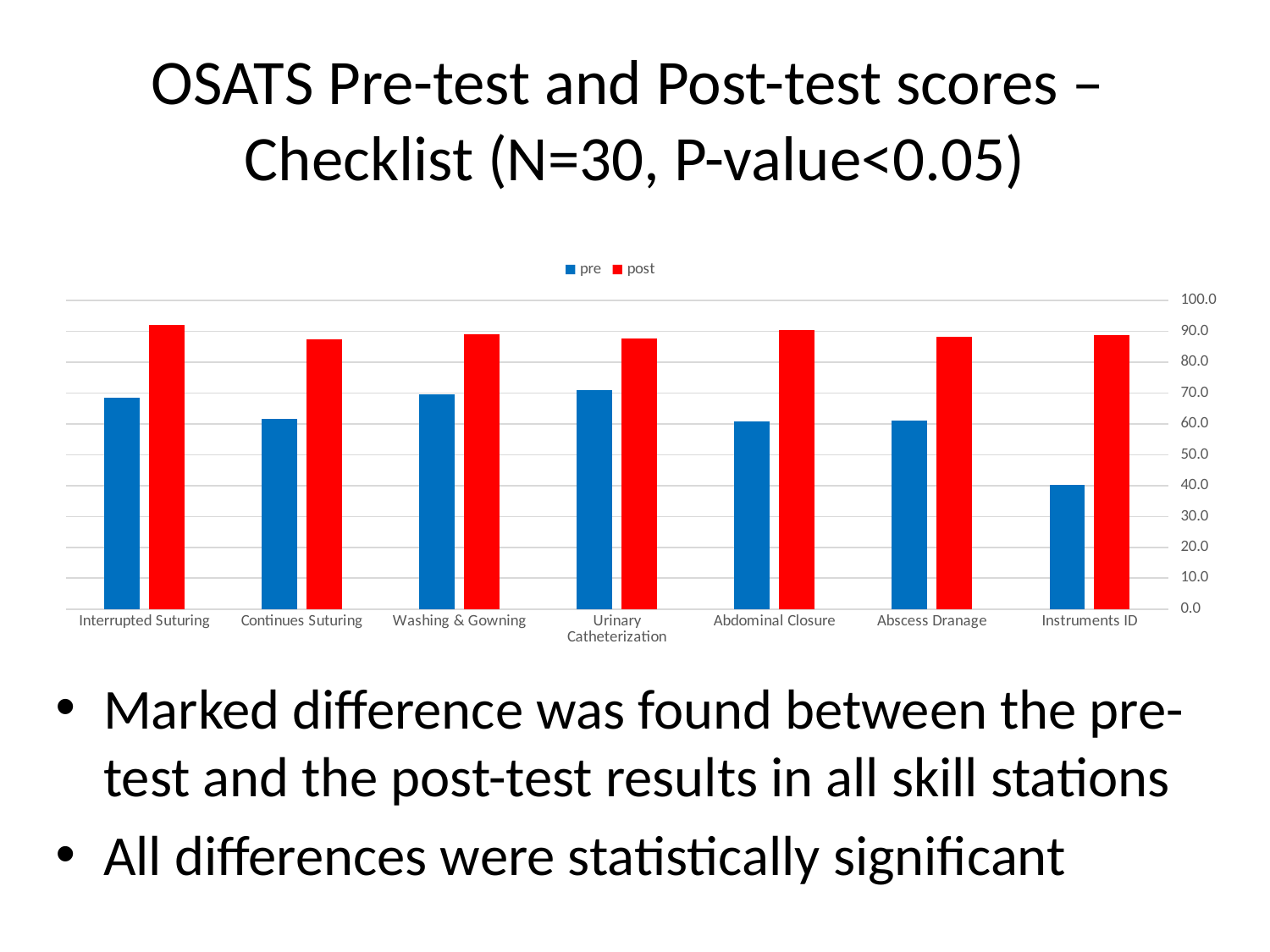
Is the post-test value for Abscess Dranage greater or less than 80? greater Which skill station has the highest post-test score? Interrupted Suturing Is the pre-test value for Instruments ID greater or less than 50? less How many skill stations (categories) are shown on the x axis? 7 What are the two series named in the legend? pre and post Which skill station has the lowest pre-test score? Instruments ID Which is larger: the pre-test score for Urinary Catheterization or the pre-test score for Instruments ID? Urinary Catheterization How many series does the legend list? 2 For Abdominal Closure, which is larger: the pre-test or the post-test score? post Is the post-test value for Interrupted Suturing greater or less than 90? greater What kind of chart is shown on the slide? bar chart